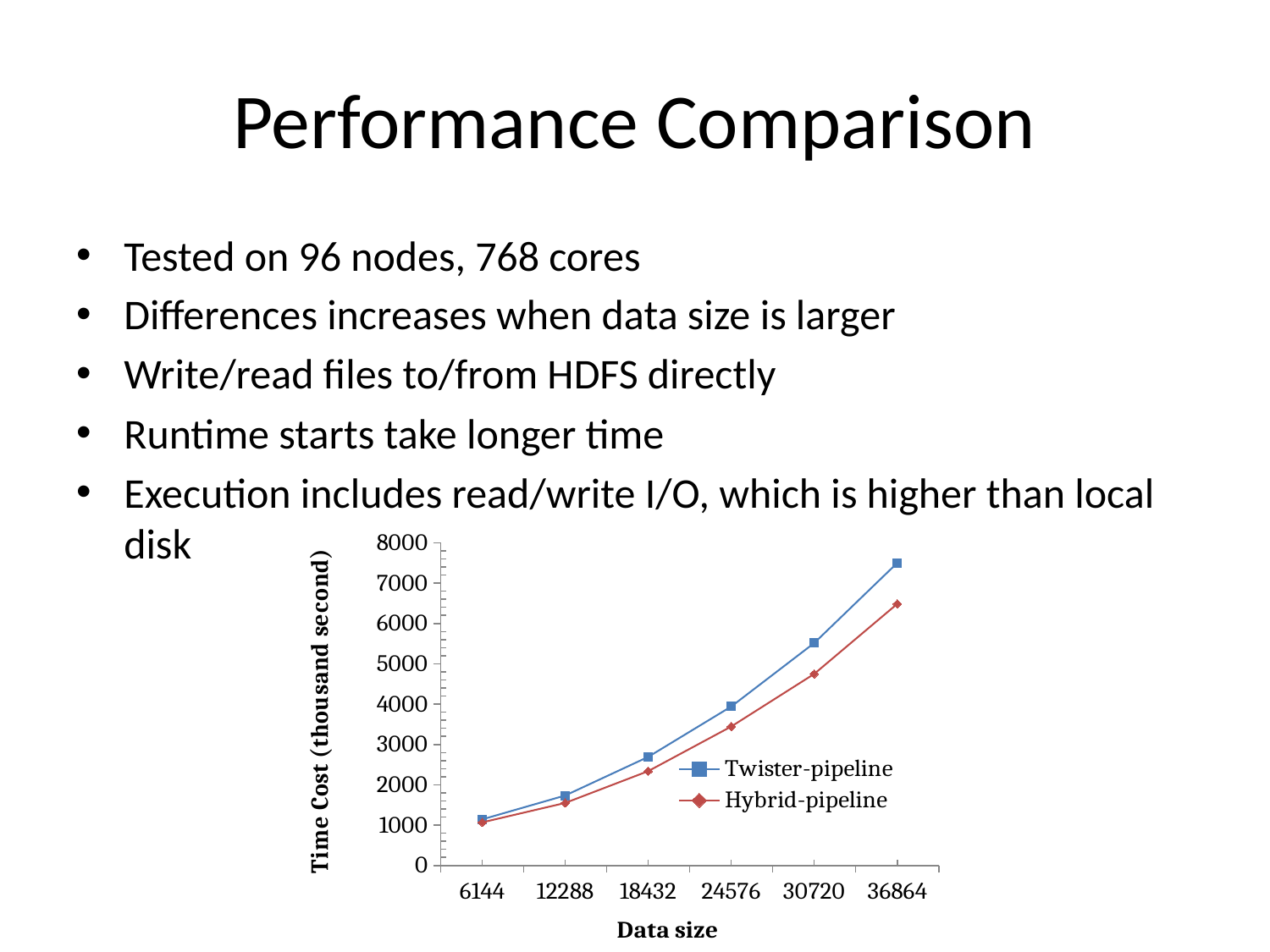
How many series does the chart legend list? 2 How many data size points are plotted along the x axis? 6 What is the label of the chart's vertical axis? Time Cost (thousand second) At which data size is the Hybrid-pipeline time cost lowest? 6144 Is the Twister-pipeline value at data size 36864 greater or less than 7000? greater Is the Hybrid-pipeline value at data size 24576 greater or less than 3000? greater Is the Twister-pipeline value at data size 18432 greater or less than 3000? less What kind of chart is shown on the slide? line chart At which data size is the Twister-pipeline time cost highest? 36864 At data size 36864, which series has the higher time cost, Twister-pipeline or Hybrid-pipeline? Twister-pipeline Does the time cost for Twister-pipeline rise or fall as data size increases? rise